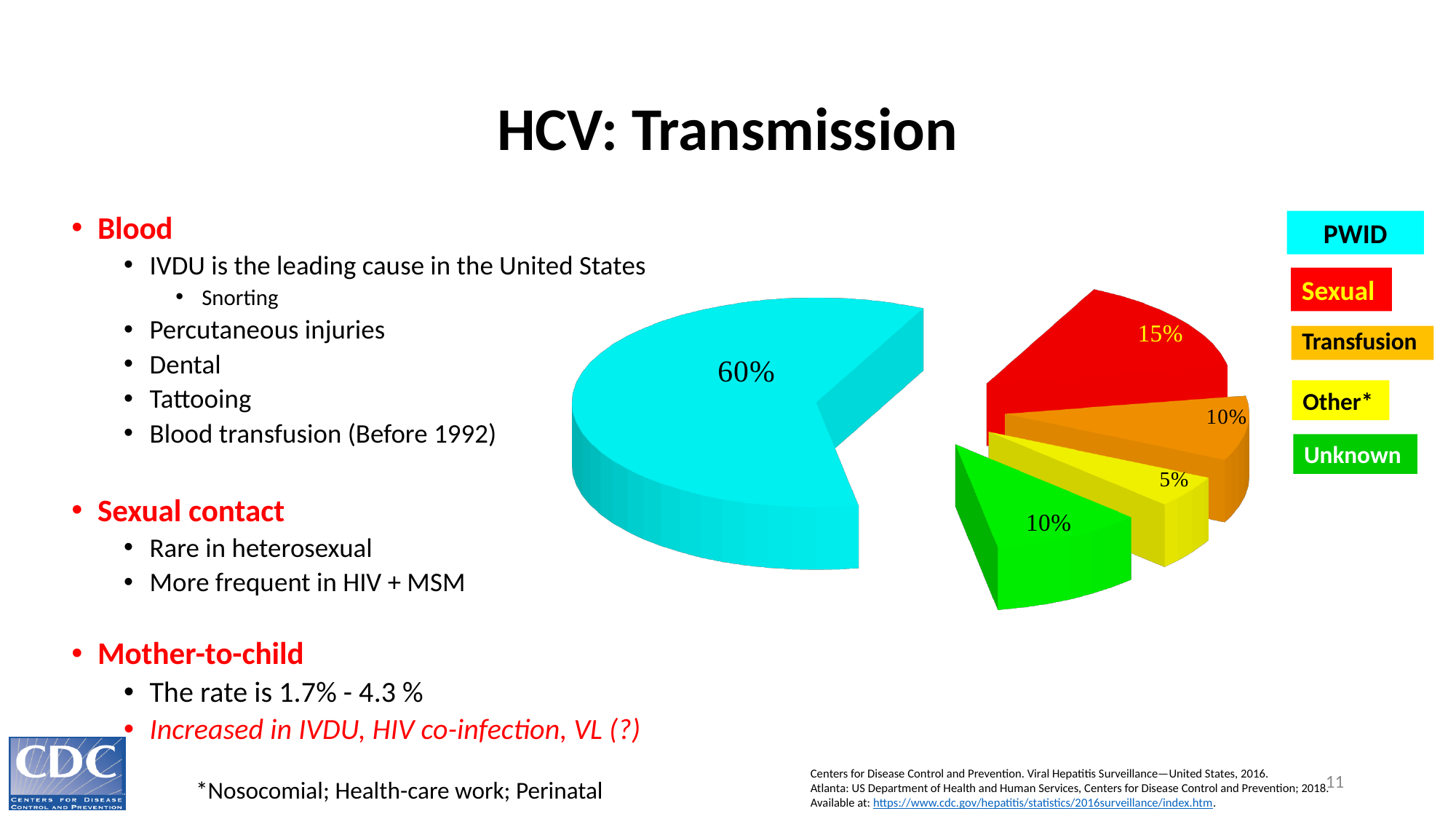
How many slices does the pie chart have? 5 Which slice is larger, Sexual or Transfusion? Sexual What percentage is shown for the Sexual slice of the pie chart? 15% Which colour represents the Unknown category in the pie chart? Green What is the difference in percentage points between the PWID slice and the Sexual slice? 45 What share of the pie chart does PWID account for? 60% What type of chart is shown on the slide? Pie chart Which category has the largest slice of the pie chart? PWID What percentage is shown for the Other* slice? 5% What percentage is shown for the Transfusion slice? 10% What percentage is shown for the Unknown slice? 10% Which category has the smallest slice of the pie chart? Other*